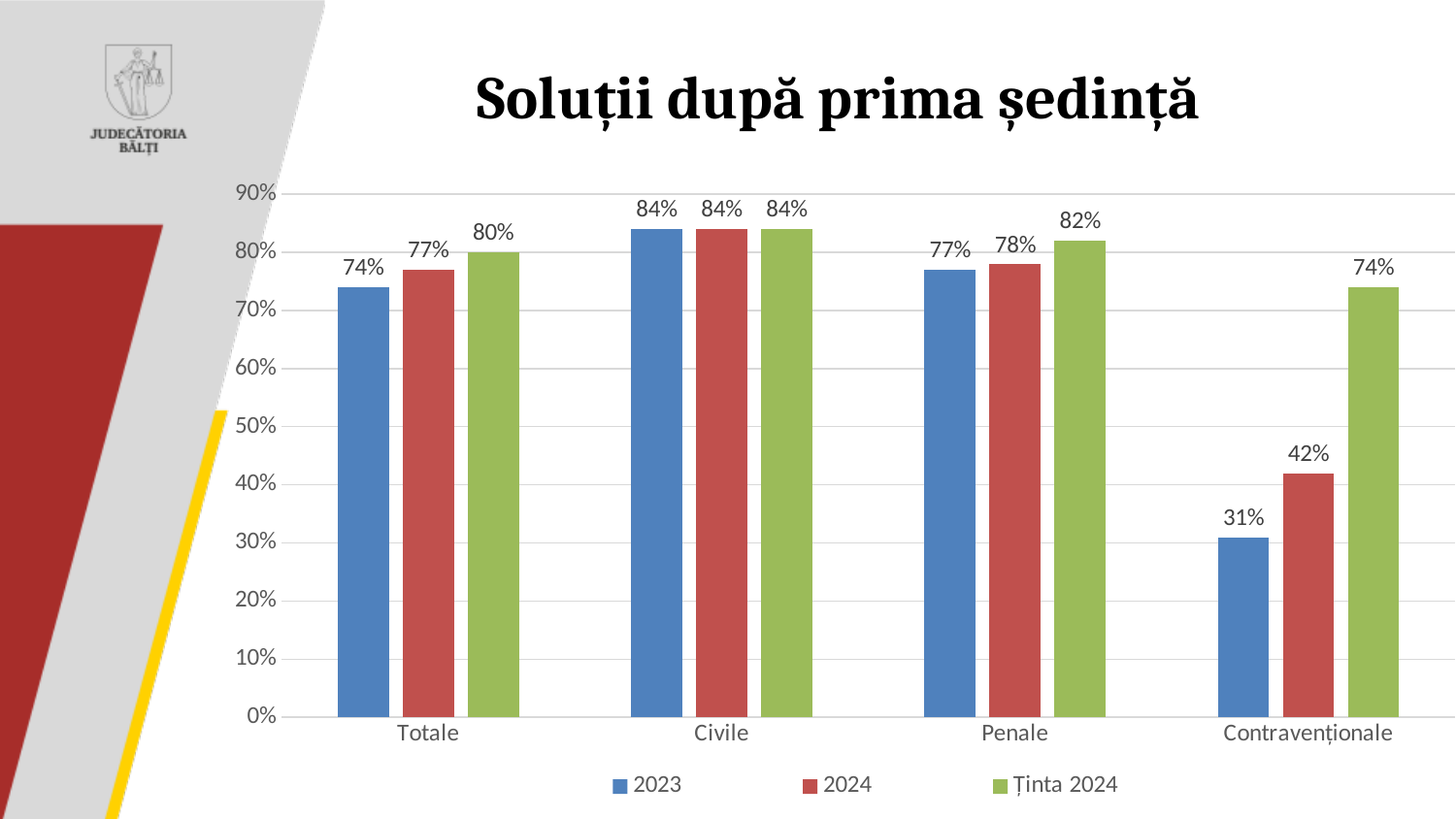
Which is larger for Totale: the 2024 value or the Ținta 2024 value? Ținta 2024 What is the 2023 value for Totale? 74% What colour represents the Ținta 2024 series? Green What is the title of the chart? Soluții după prima ședință What is the 2024 value for Penale? 78% How many series does the legend list? 3 How many categories are shown on the x axis? 4 Which category has the lowest 2023 value? Contravenționale What is the difference between the Ținta 2024 and 2024 values for Contravenționale? 32% What is the Ținta 2024 value for Contravenționale? 74% Which category has the highest 2024 value? Civile What kind of chart is shown on the slide? Bar chart